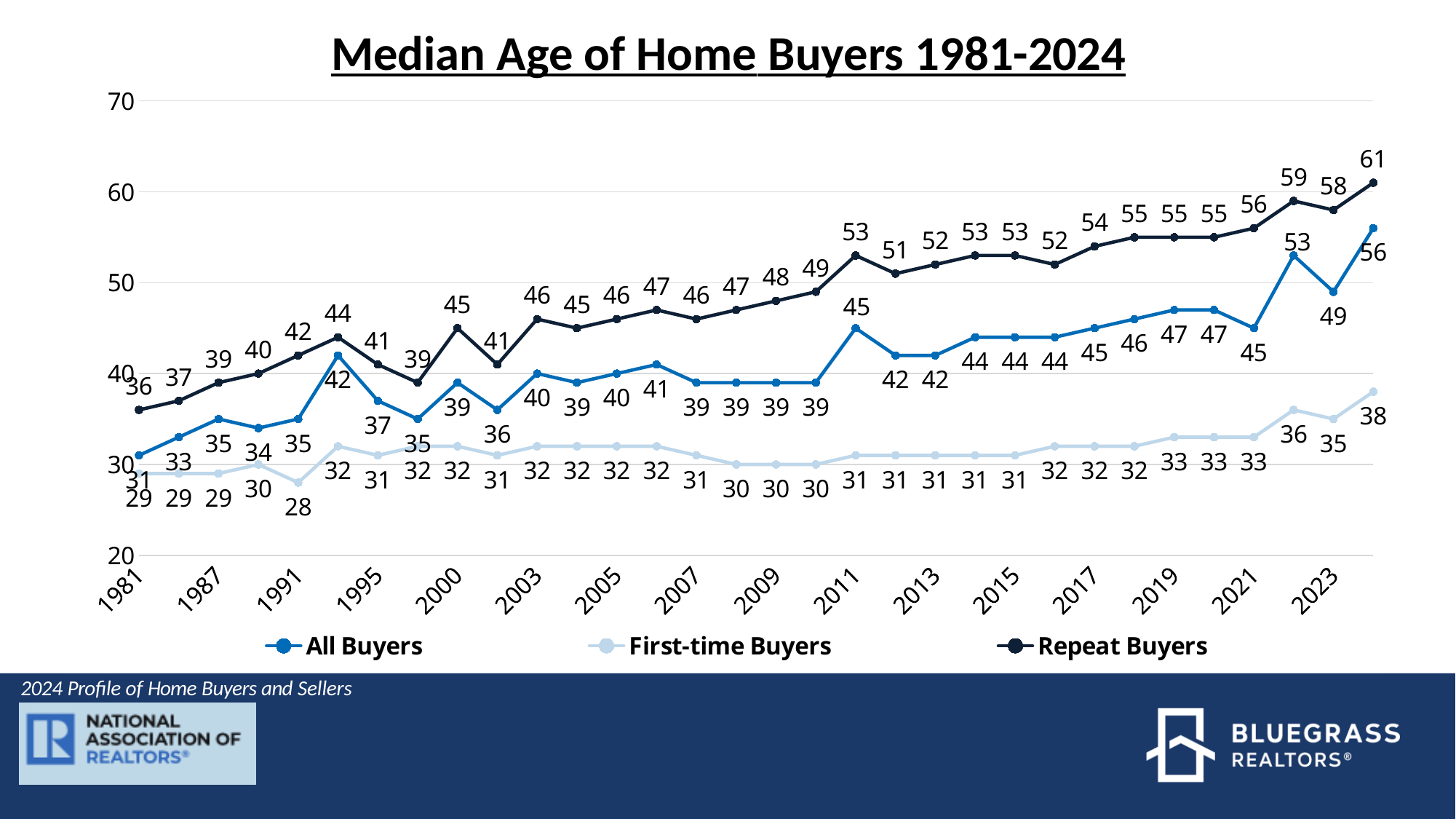
In 1981, how much higher is the Repeat Buyers median age than the All Buyers median age? 5 What is the lowest median age shown for First-time Buyers? 28 What kind of chart is shown on the slide? Line chart Does the Repeat Buyers line generally rise or fall from 1981 to 2024? Rise At the final data point (2024), what is the difference between the Repeat Buyers median age (61) and the First-time Buyers median age (38)? 23 What is the median age of First-time Buyers in 1981? 29 What is the highest median age shown for Repeat Buyers? 61 How many series does the legend list? 3 In 1981, which is higher: the median age of All Buyers or of First-time Buyers? All Buyers What is the median age of All Buyers at the final data point (2024)? 56 What is the median age of Repeat Buyers in 1981? 36 What is the title of the chart? Median Age of Home Buyers 1981-2024